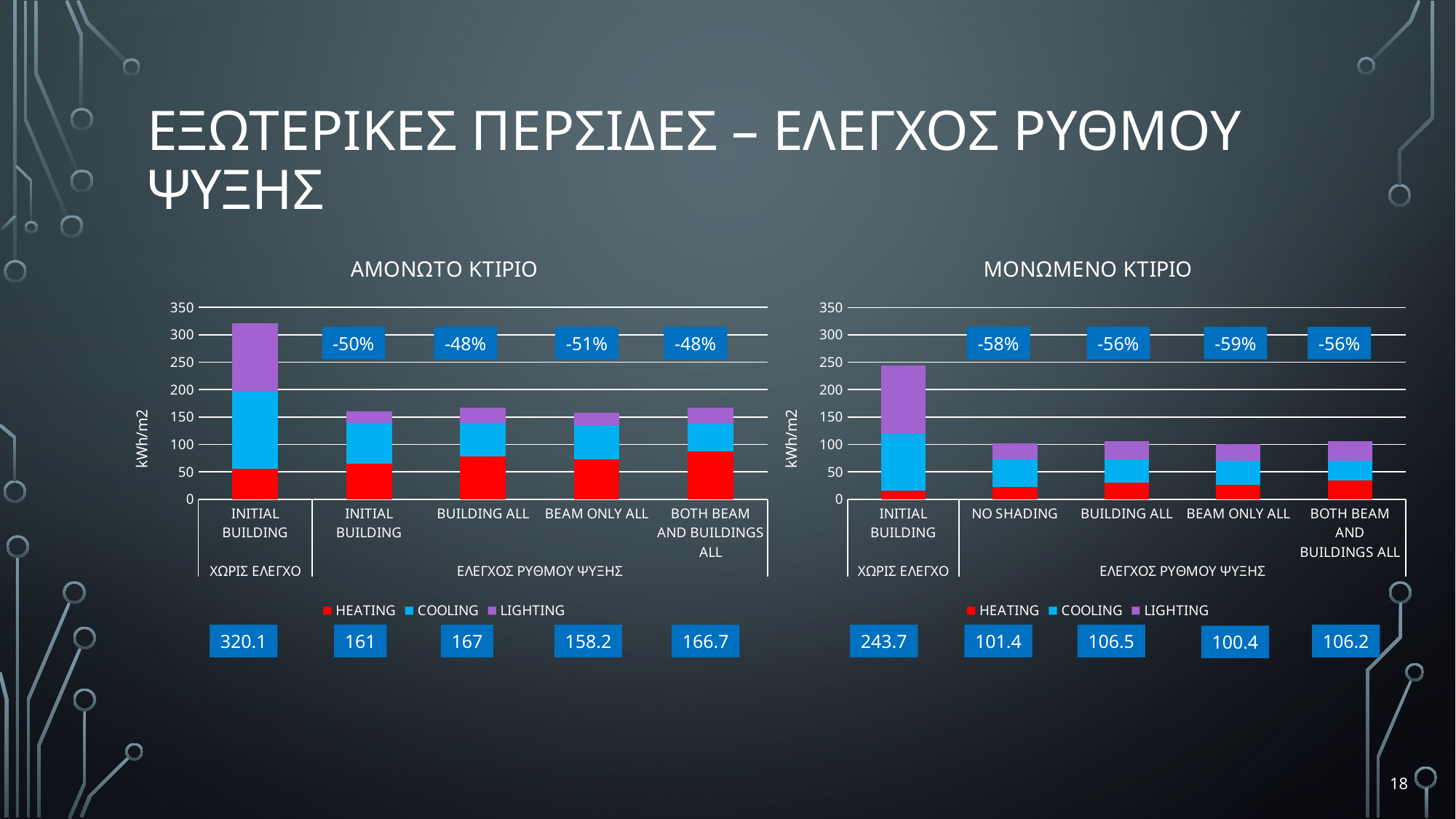
In the ΜΟΝΩΜΕΝΟ ΚΤΙΡΙΟ chart, what is the difference between the INITIAL BUILDING total and the NO SHADING total? 142.3 What type of chart is the ΑΜΟΝΩΤΟ ΚΤΙΡΙΟ chart? Stacked bar chart In the ΜΟΝΩΜΕΝΟ ΚΤΙΡΙΟ chart, which category has the lowest total? BEAM ONLY ALL How many series does the legend of the ΑΜΟΝΩΤΟ ΚΤΙΡΙΟ chart list? 3 In the ΑΜΟΝΩΤΟ ΚΤΙΡΙΟ chart, what is the total value for BEAM ONLY ALL? 158.2 In the ΜΟΝΩΜΕΝΟ ΚΤΙΡΙΟ chart, what is the total value for BOTH BEAM AND BUILDINGS ALL? 106.2 In the ΜΟΝΩΜΕΝΟ ΚΤΙΡΙΟ chart, what is the total value for NO SHADING? 101.4 In the ΑΜΟΝΩΤΟ ΚΤΙΡΙΟ chart, is the HEATING value for INITIAL BUILDING under ΧΩΡΙΣ ΕΛΕΓΧΟ greater or less than 100? less In the ΑΜΟΝΩΤΟ ΚΤΙΡΙΟ chart, what percentage reduction is shown for BEAM ONLY ALL? -51% In the ΜΟΝΩΜΕΝΟ ΚΤΙΡΙΟ chart, what percentage reduction is shown for BUILDING ALL? -56% In the ΑΜΟΝΩΤΟ ΚΤΙΡΙΟ chart, which category has the highest total? INITIAL BUILDING (ΧΩΡΙΣ ΕΛΕΓΧΟ)